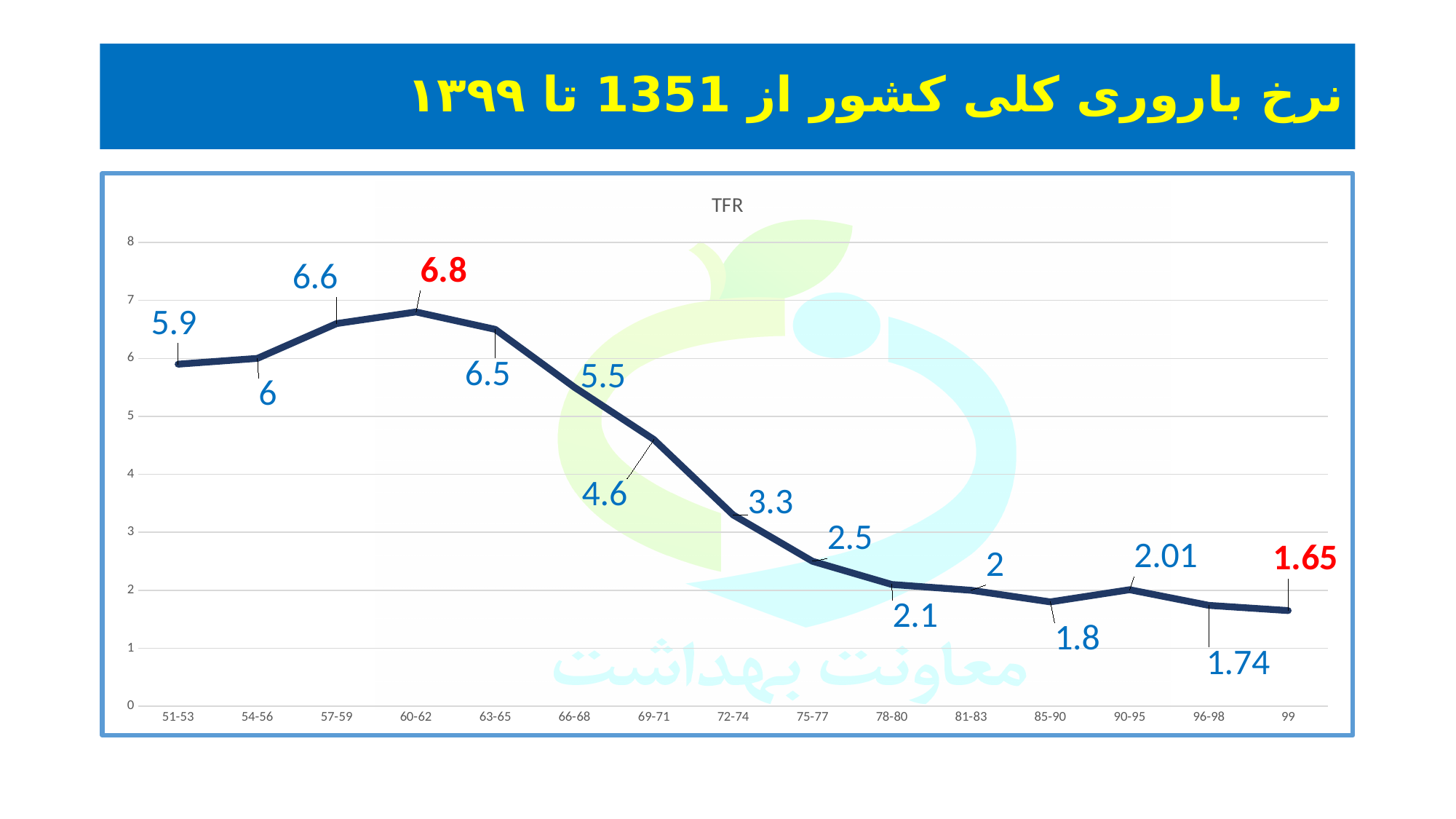
Which is larger, the TFR value for 57-59 or for 63-65? 57-59 What type of chart is shown on the slide? line chart How many periods are shown on the x axis? 15 What is the TFR value for 72-74? 3.3 Does the TFR value generally rise or fall from 63-65 to 99? fall Which period has the lowest TFR value? 99 What is the TFR value for 60-62? 6.8 What is the title of the chart? TFR What is the TFR value for 99? 1.65 Which period has the highest TFR value? 60-62 What is the difference between the TFR values for 60-62 and 99? 5.15 What is the TFR value for 90-95? 2.01